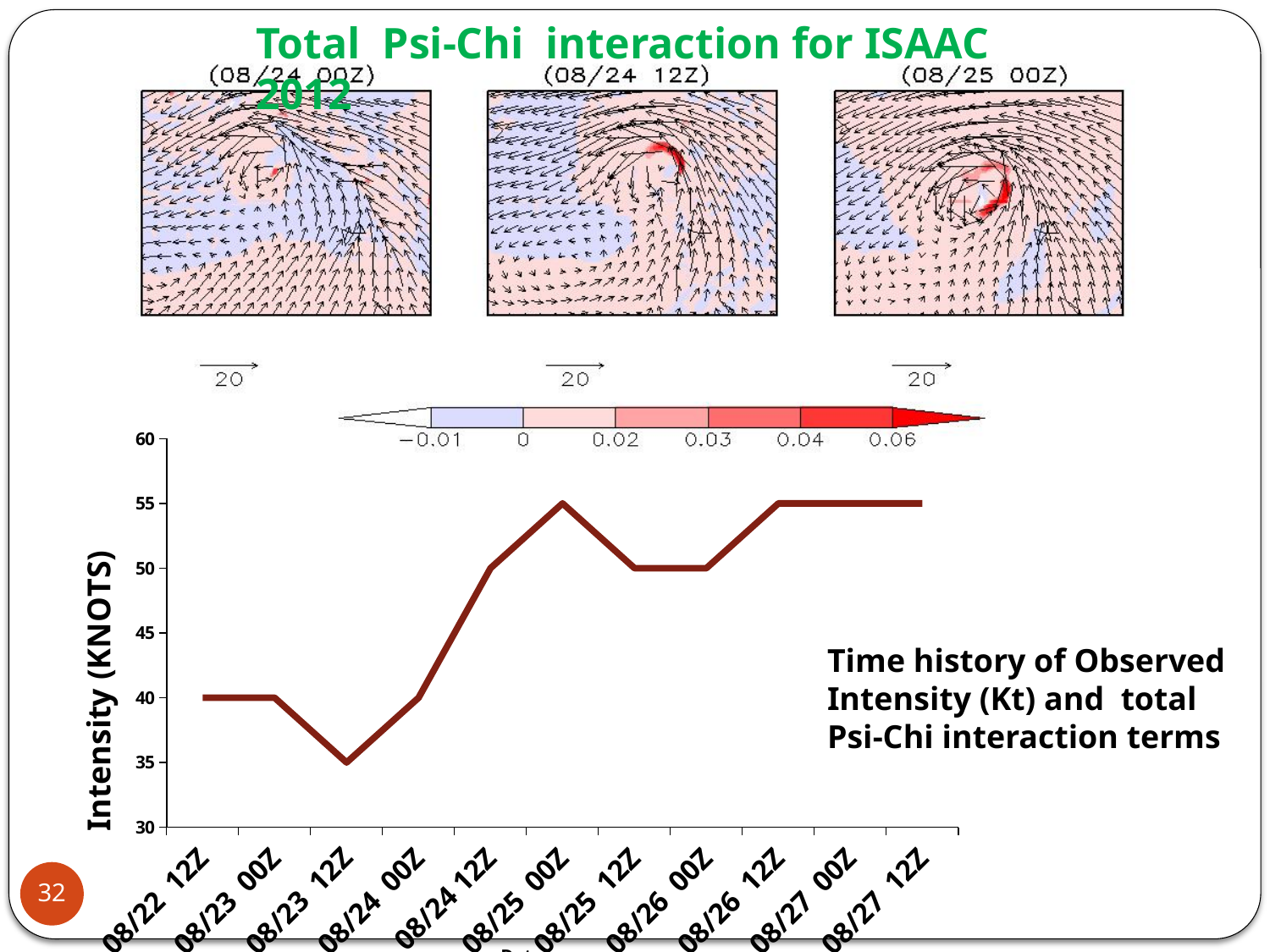
In the intensity line chart, what is the difference in intensity between 08/25 00Z and 08/23 12Z? 20 What is the y-axis label of the intensity line chart? Intensity (KNOTS) In the intensity line chart, what is the intensity at 08/25 00Z? 55 In the intensity line chart, what is the intensity at 08/23 12Z? 35 In the intensity line chart, does the intensity rise or fall between 08/24 00Z and 08/25 00Z? rise In the intensity line chart, at which date/time is the intensity lowest? 08/23 12Z In the intensity line chart, is the intensity at 08/26 00Z greater or less than 45? greater How many date/time points are shown on the x axis of the intensity line chart? 11 In the intensity line chart, which is larger: the intensity at 08/24 12Z or at 08/24 00Z? 08/24 12Z In the intensity line chart, what is the intensity at 08/24 12Z? 50 In the intensity line chart, what is the intensity at 08/22 12Z? 40 What kind of chart is the intensity chart at the bottom of the slide? line chart